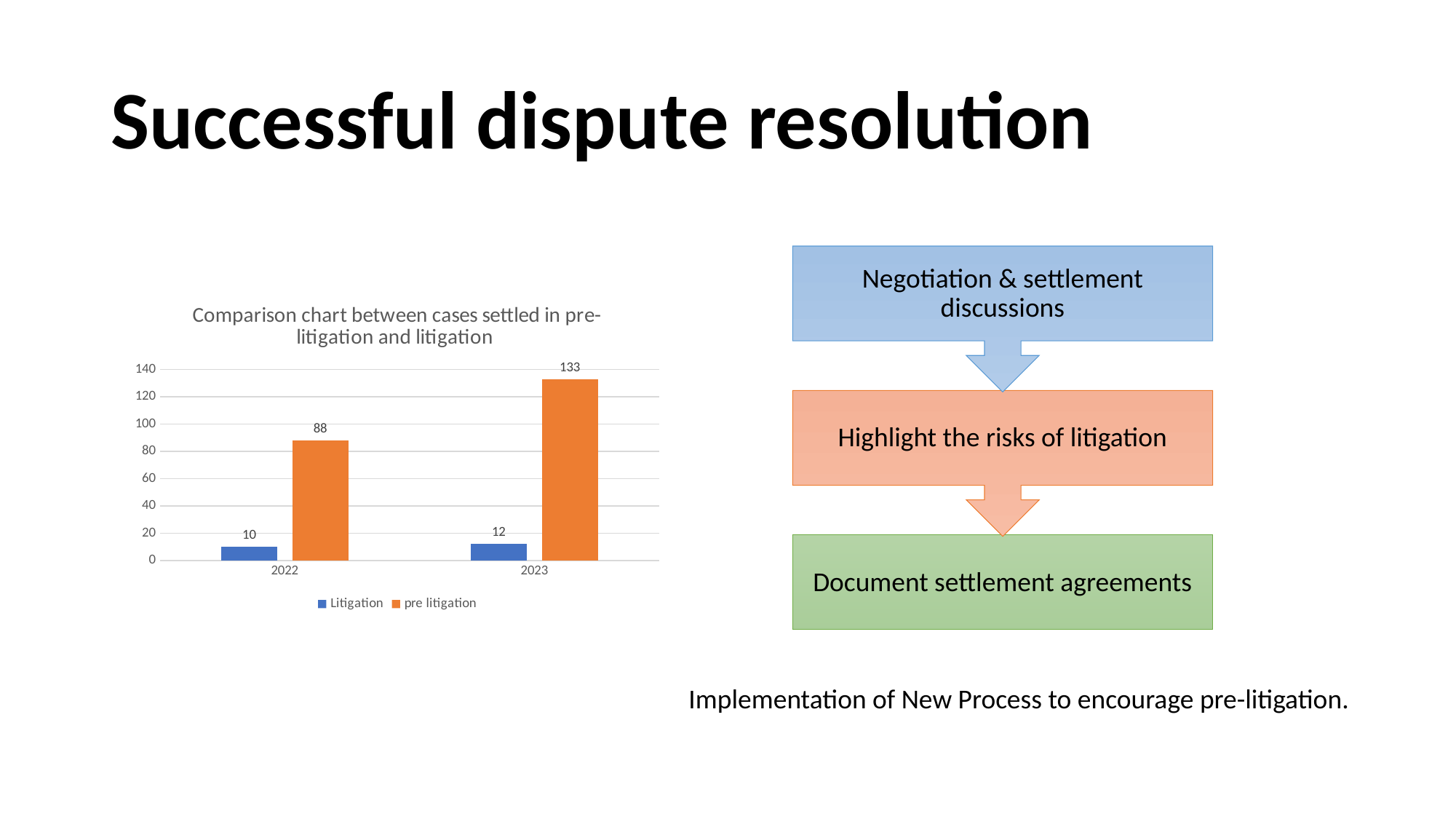
How many series does the legend list? 2 Does the pre litigation value rise or fall from 2022 to 2023? rise Which is larger in 2023, Litigation or pre litigation? pre litigation Which year has the lowest Litigation value? 2022 What is the value for Litigation in 2022? 10 What is the difference between the pre litigation values for 2023 and 2022? 45 What is the value for pre litigation in 2022? 88 What kind of chart is shown on the slide? bar chart Which year has the highest pre litigation value? 2023 How many categories are shown on the x axis? 2 What is the value for pre litigation in 2023? 133 What is the value for Litigation in 2023? 12